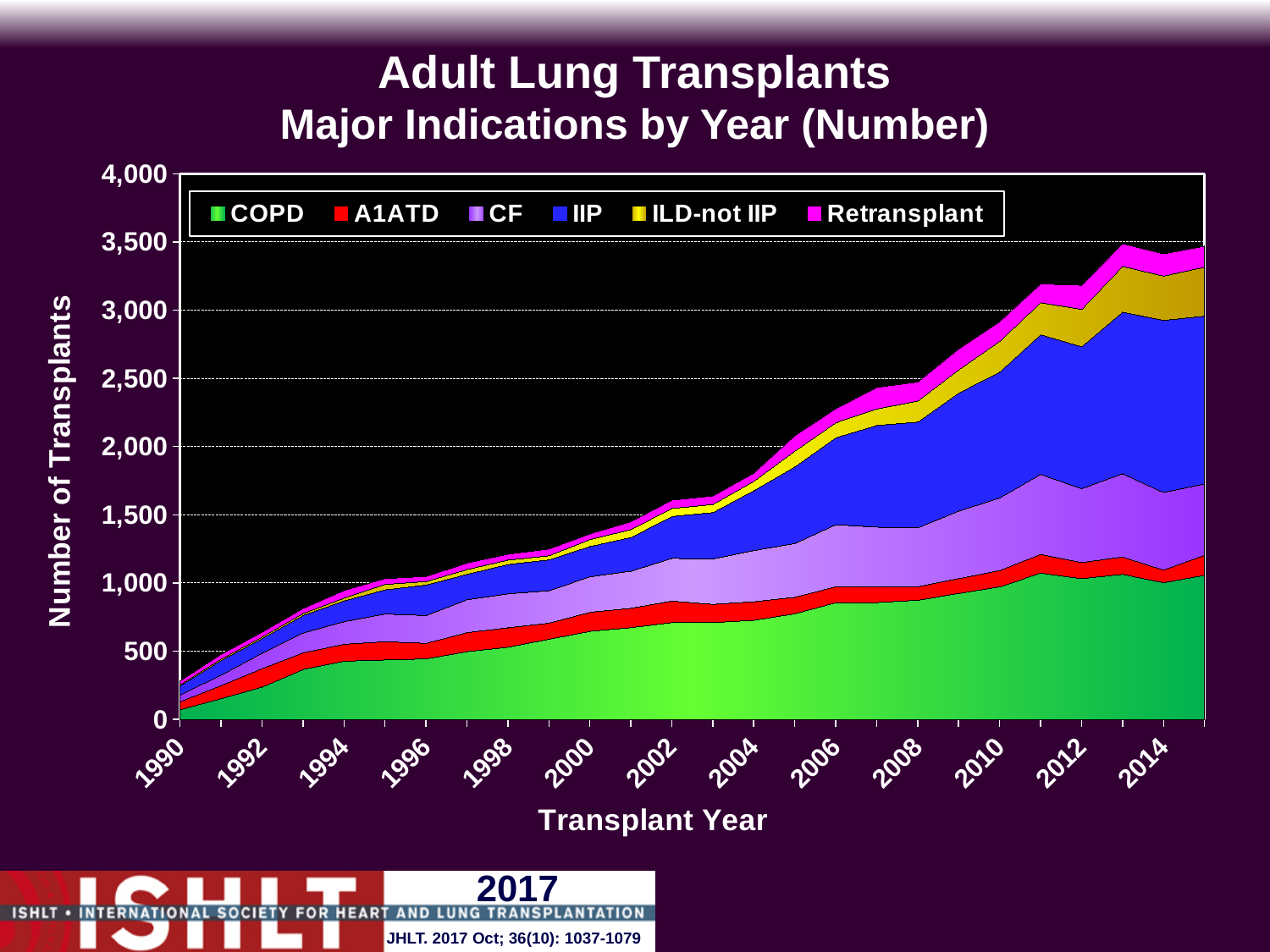
How many year labels are shown on the x axis? 13 Which year shown has the lowest total number of transplants? 1990 Does the total number of transplants generally rise or fall from 1990 to 2014? Rise Which indications are listed in the legend? COPD, A1ATD, CF, IIP, ILD-not IIP, Retransplant Is the total number of transplants in 2006 greater or less than 2,000? greater How many series does the legend list? 6 Is the total number of transplants in 2008 greater or less than 3,000? less Is the total number of transplants in 1990 greater or less than 500? less What is the title of the chart? Adult Lung Transplants Major Indications by Year (Number) What kind of chart is shown on the slide? Stacked area chart